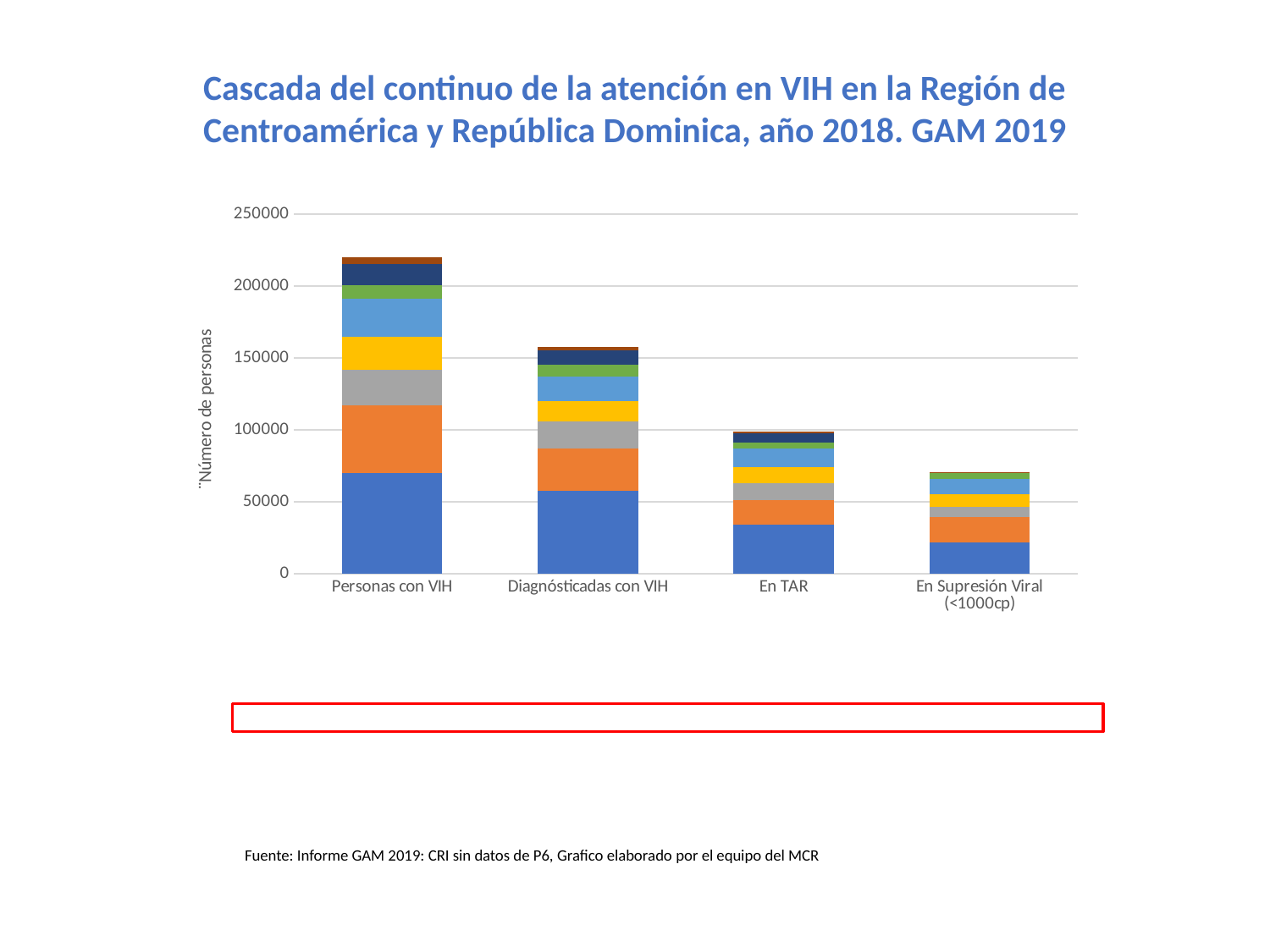
Which category has the tallest stacked bar? Personas con VIH What is the label on the vertical axis of the chart? Número de personas Is the total for En Supresión Viral (<1000cp) greater or less than 100000? less What kind of chart is shown on the slide? Stacked bar chart Which category has the shortest stacked bar? En Supresión Viral (<1000cp) Is the total for En TAR greater or less than 50000? greater Is the total for Personas con VIH greater or less than 200000? greater Do the bar totals rise or fall from left to right along the x axis? Fall Which has the larger total, En TAR or En Supresión Viral (<1000cp)? En TAR How many categories are shown on the x axis of the chart? 4 What year of data does the chart title say it covers? 2018